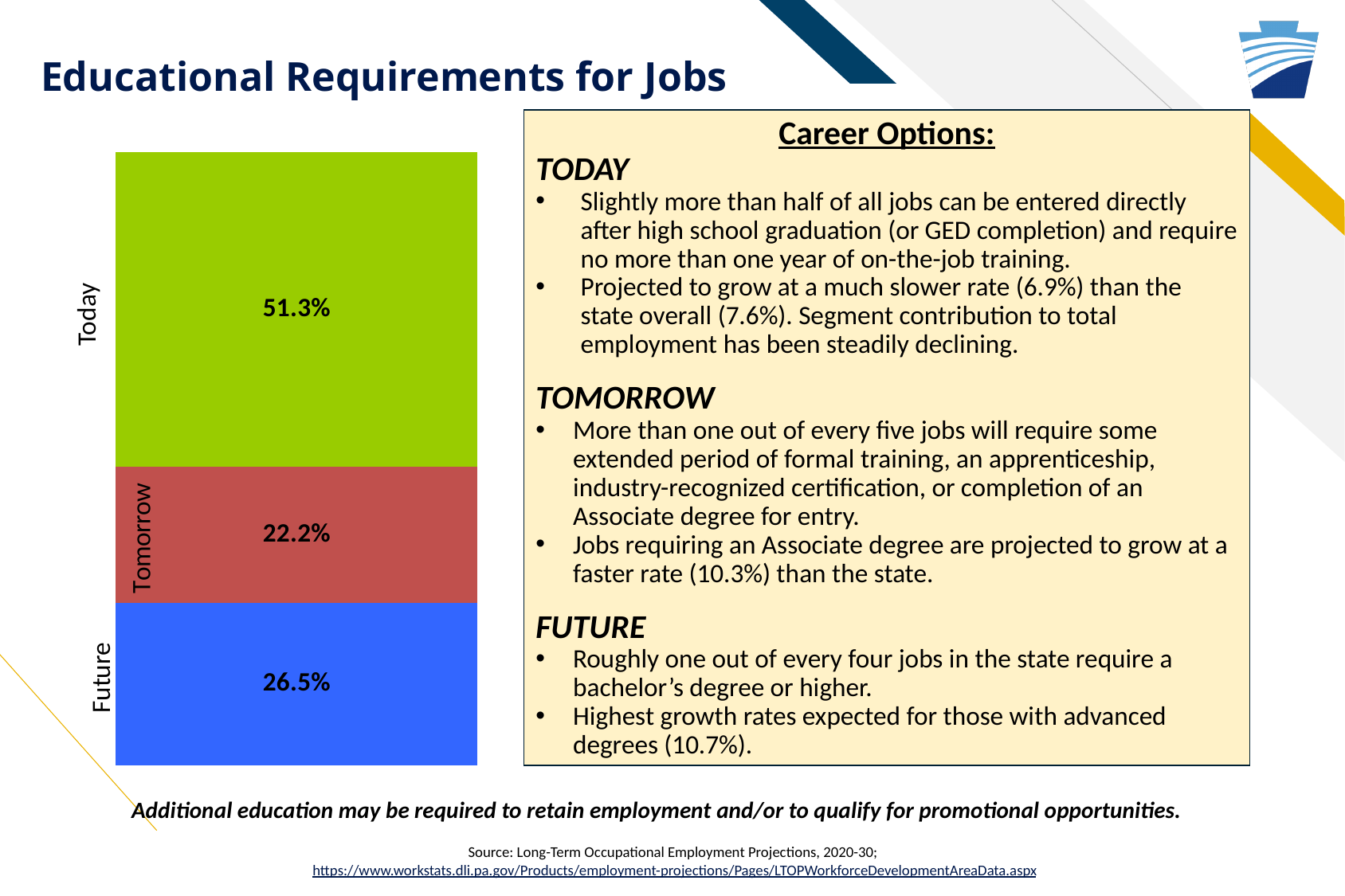
How many segments make up the stacked bar? 3 What percentage is shown for the Today segment of the stacked bar? 51.3% What kind of chart is shown on the slide? Stacked bar chart What percentage is shown for the Future segment of the stacked bar? 26.5% What is the total of the three segments in the stacked bar? 100% What is the difference in percentage points between the Future and Tomorrow segments? 4.3 What colour is the Future segment of the stacked bar? Blue Which is larger, the Future segment or the Tomorrow segment? Future What percentage is shown for the Tomorrow segment of the stacked bar? 22.2% Which segment of the stacked bar has the largest value? Today Which segment of the stacked bar has the smallest value? Tomorrow What is the difference in percentage points between the Today and Tomorrow segments? 29.1